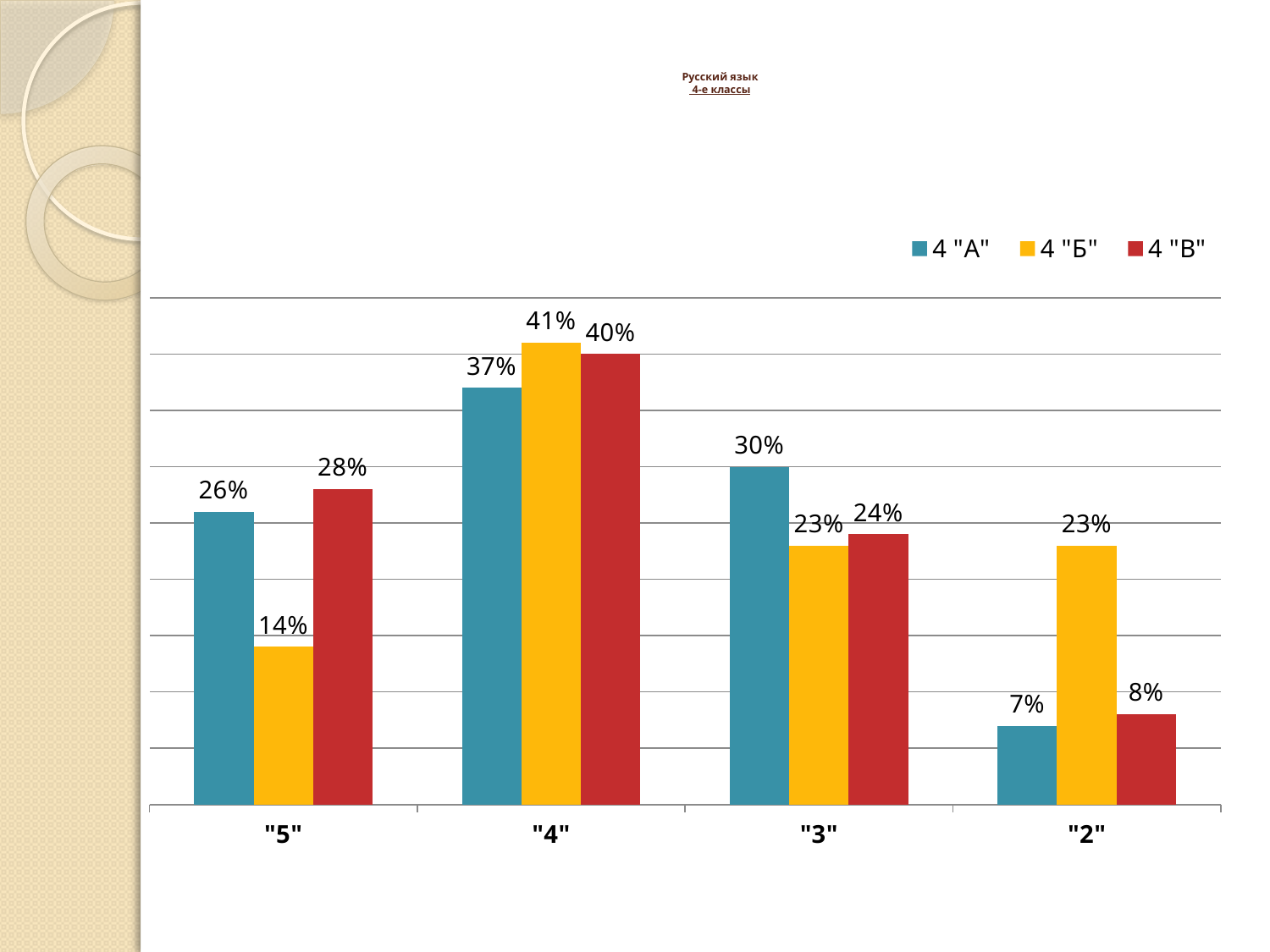
How many series does the legend list? 3 Which grade category has the highest value for 4 "Б"? "4" What is the value for 4 "В" in the "4" category? 40% What is the difference between 4 "А" and 4 "Б" in the "3" category? 7% Which colour represents 4 "Б" in the legend? Yellow How many grade categories are shown on the x axis? 4 What is the value for 4 "Б" in the "2" category? 23% Which grade category has the lowest value for 4 "А"? "2" What kind of chart is shown on the slide? Bar chart What is the value for 4 "А" in the "5" category? 26% In the "5" category, which is larger: 4 "Б" or 4 "В"? 4 "В" What is the title of the chart? Русский язык 4-е классы